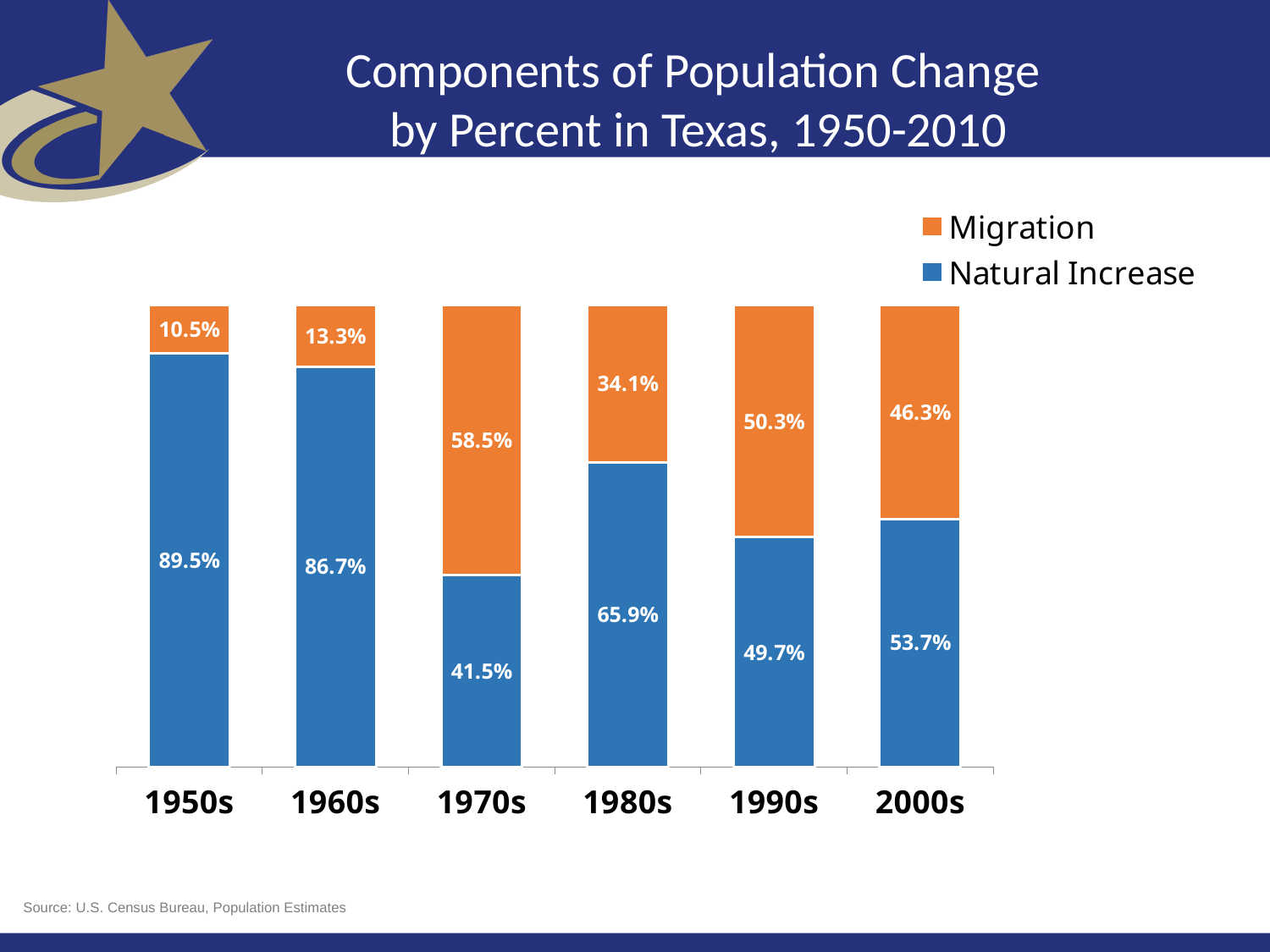
Which colour represents Migration in the chart? Orange How many series does the legend list? 2 Which decade has the highest Migration value? 1970s What kind of chart is shown on the slide? Stacked bar chart What is the difference between the Natural Increase and Migration values in the 1980s? 31.8% Which is larger in the 1990s, Migration or Natural Increase? Migration What is the Natural Increase value for the 1950s? 89.5% What is the Migration value for the 2000s? 46.3% Which decade has the lowest Natural Increase value? 1970s What is the Migration value for the 1970s? 58.5% Does the Natural Increase value rise or fall from the 1950s to the 1970s? Fall How many decades are shown on the x axis? 6